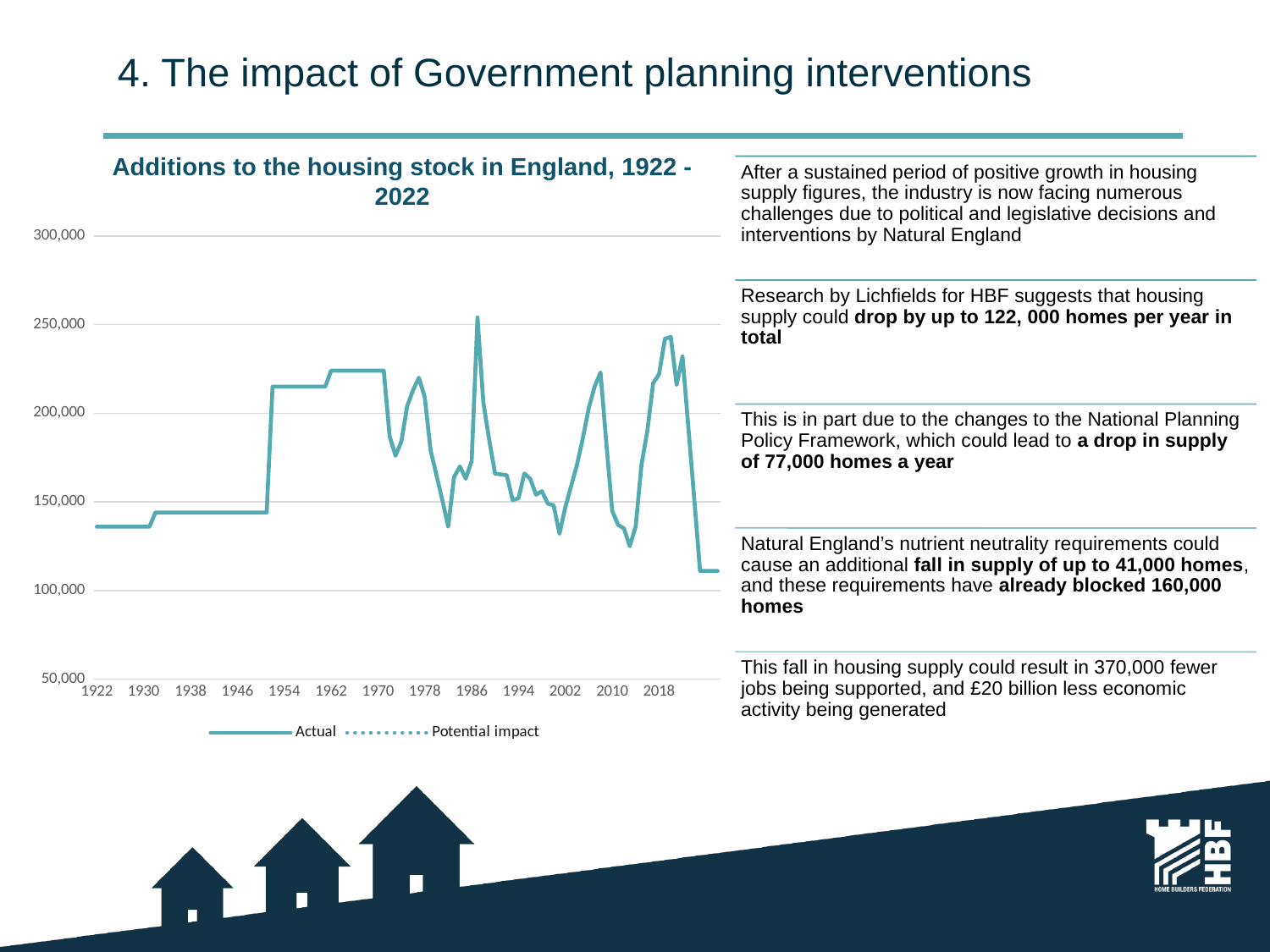
What are the two series named in the chart legend? Actual and Potential impact Is the highest peak of the Actual line greater or less than 200,000? greater Which is larger, the Actual value for 1962 or for 1922? 1962 What kind of chart is shown on the slide? Line chart Which is larger, the Actual value for 1922 or for 2022? 2022 What is the title of the chart? Additions to the housing stock in England, 1922 - 2022 How many year labels are shown on the x axis? 13 How many series does the chart legend list? 2 Is the Actual value for 1922 greater or less than 150,000? less Is the Actual value for 1962 greater or less than 200,000? greater Does the Actual line rise or fall between 1922 and 1954? rise